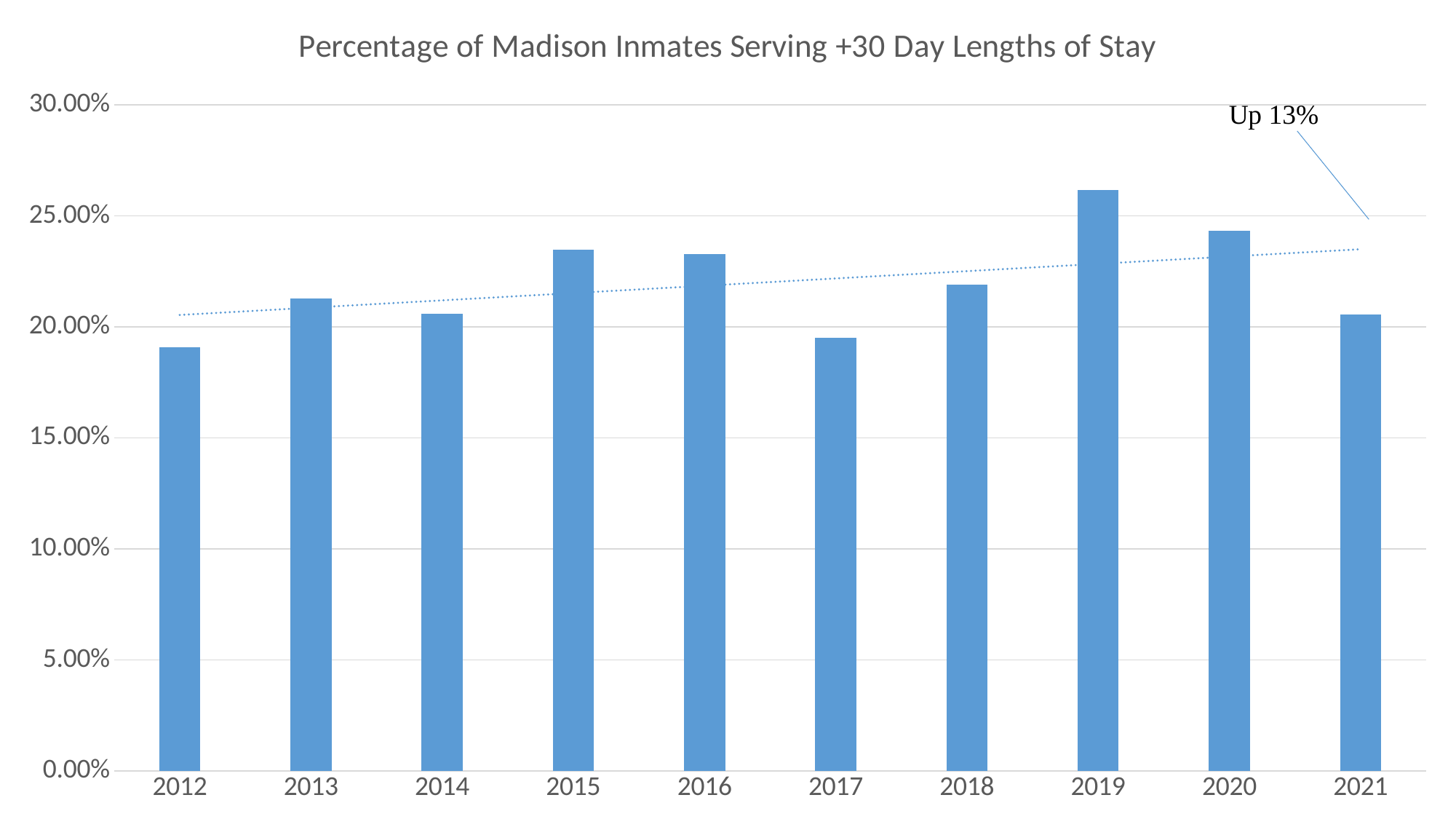
Which year has the larger value, 2019 or 2020? 2019 What is the title of the chart? Percentage of Madison Inmates Serving +30 Day Lengths of Stay Which year has the highest percentage of inmates serving +30 day lengths of stay? 2019 Is the value for 2017 greater or less than 20.00%? less What type of chart is shown on the slide? Bar chart Which year has the larger value, 2018 or 2021? 2018 Is the value for 2020 greater or less than 25.00%? less Is the value for 2015 greater or less than 20.00%? greater Does the dotted trendline rise or fall from 2012 to 2021? rise How many years are shown on the x axis of the chart? 10